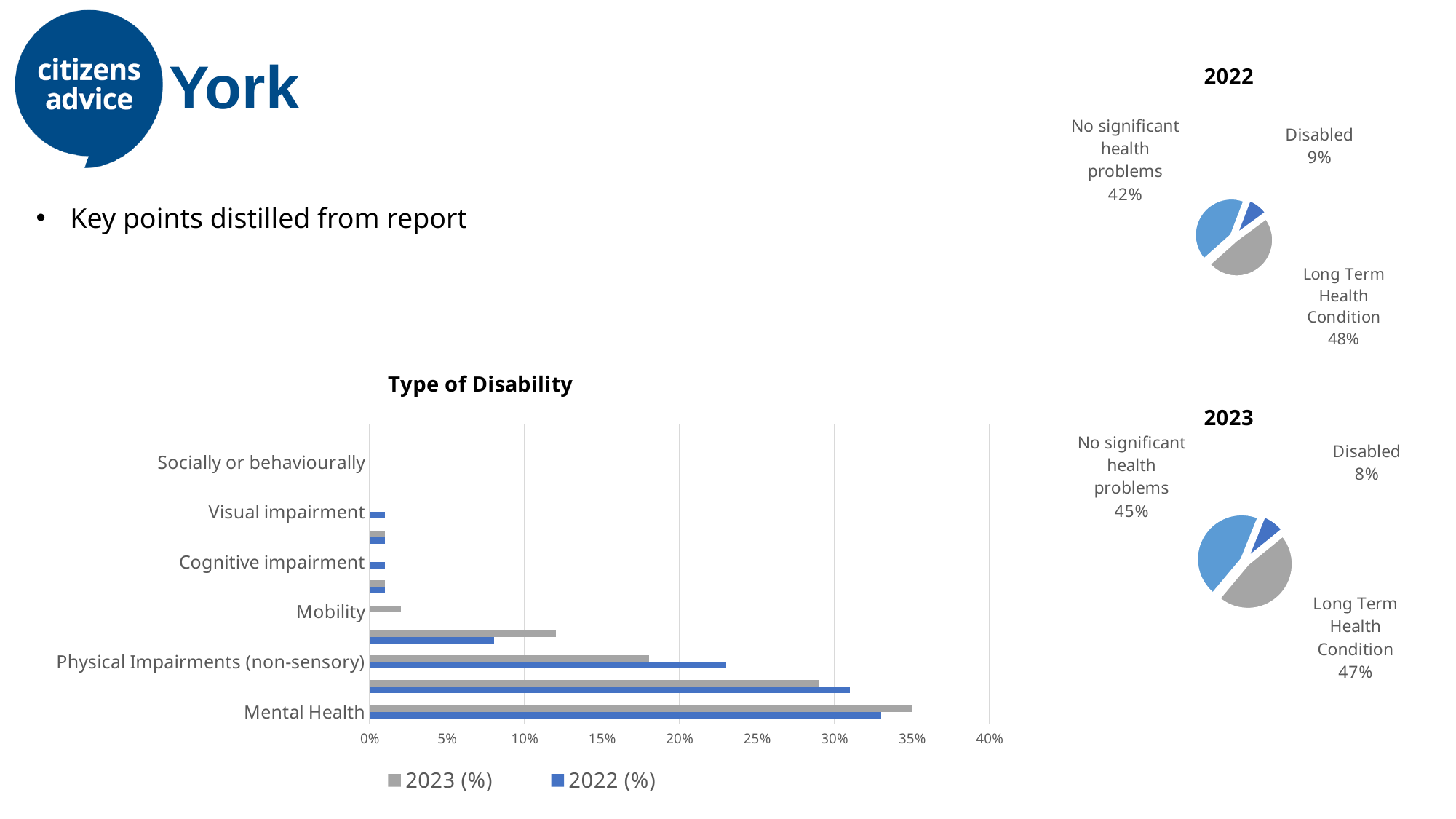
What kind of chart is the 'Type of Disability' chart? bar chart In the 'Type of Disability' chart, is the 2023 (%) value for Physical Impairments (non-sensory) greater or less than 20%? less How many series does the legend of the 'Type of Disability' chart list? 2 In the 2023 pie chart, which category has the largest share? Long Term Health Condition How many slices does the 2022 pie chart have? 3 In the 2023 pie chart, what is the difference between the Long Term Health Condition share and the No significant health problems share? 2% In the 'Type of Disability' chart, is the 2023 (%) value for Mental Health greater or less than 30%? greater In the 2022 pie chart, which category has the smallest share? Disabled In the 'Type of Disability' chart, is the 2022 (%) value for Physical Impairments (non-sensory) greater or less than 20%? greater In the 2022 pie chart, what share is Long Term Health Condition? 48% In the 2022 pie chart, what share is Disabled? 9% In the 2023 pie chart, what share is No significant health problems? 45%